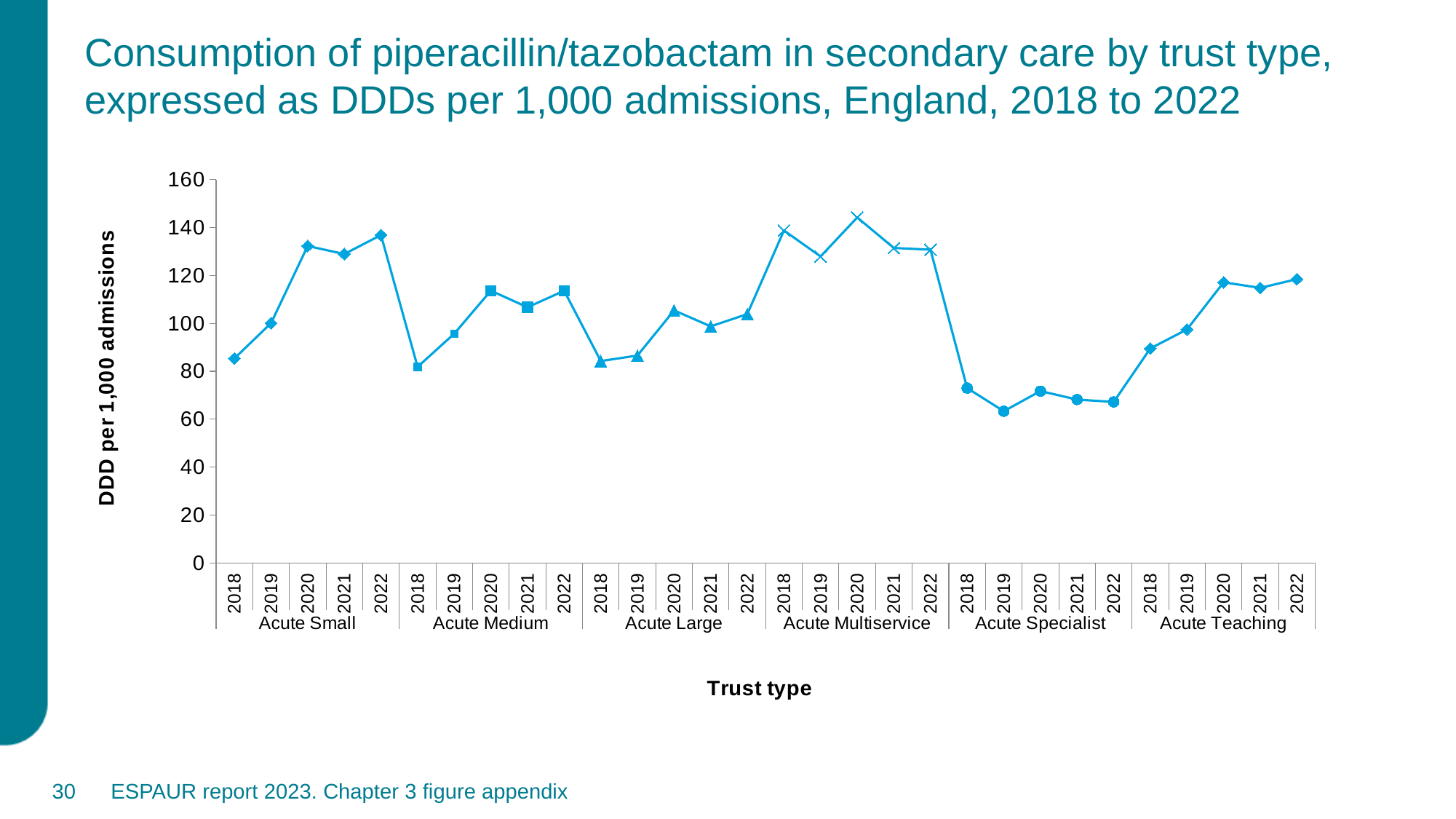
What kind of chart is shown on the slide? Line chart Which is larger: the value for Acute Small in 2022 or the value for Acute Medium in 2022? Acute Small in 2022 How many trust types are shown along the x axis? 6 How many data points are plotted in total across all trust types? 30 Is the value for Acute Medium in 2020 greater or less than 100? greater What is the title of the y axis? DDD per 1,000 admissions Which trust type and year has the highest value on the chart? Acute Multiservice, 2020 Is the value for Acute Multiservice in 2020 greater or less than 140? greater Which trust type and year has the lowest value on the chart? Acute Specialist, 2019 Do the values for Acute Teaching rise or fall from 2018 to 2020? Rise Is the value for Acute Large in 2018 greater or less than 100? less